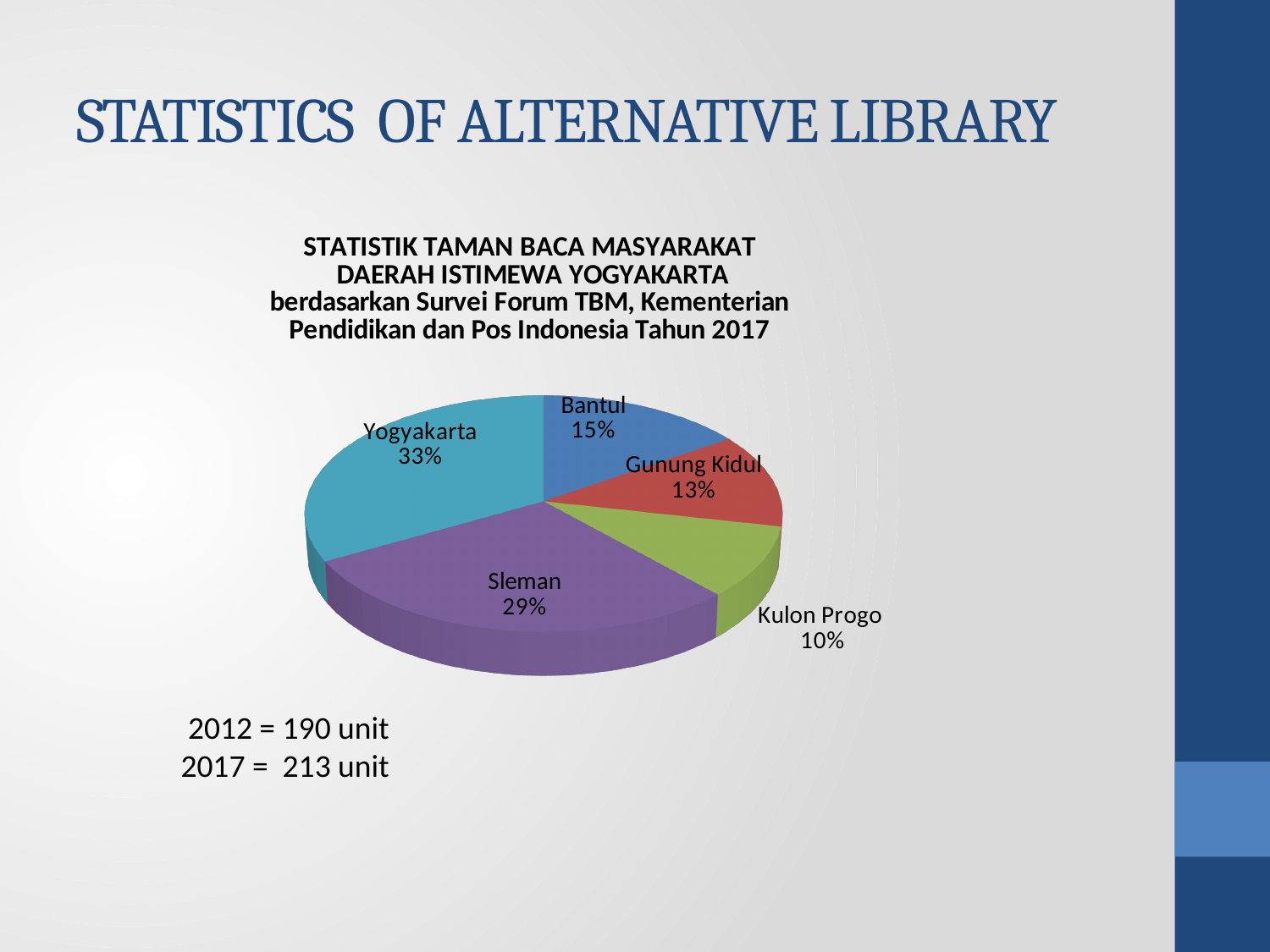
Which is larger, the slice for Gunung Kidul or the slice for Bantul? Bantul What is the value shown for Gunung Kidul? 13% What is the value shown for Kulon Progo? 10% What share of the pie does Yogyakarta have? 33% What share of the pie does Sleman have? 29% What kind of chart is shown on the slide? Pie chart What is the difference in percentage points between Bantul and Kulon Progo? 5 Which category has the largest slice of the pie? Yogyakarta What is the value shown for Bantul? 15% Which category has the smallest slice of the pie? Kulon Progo How many categories are shown in the pie chart? 5 What is the difference in percentage points between Yogyakarta and Sleman? 4